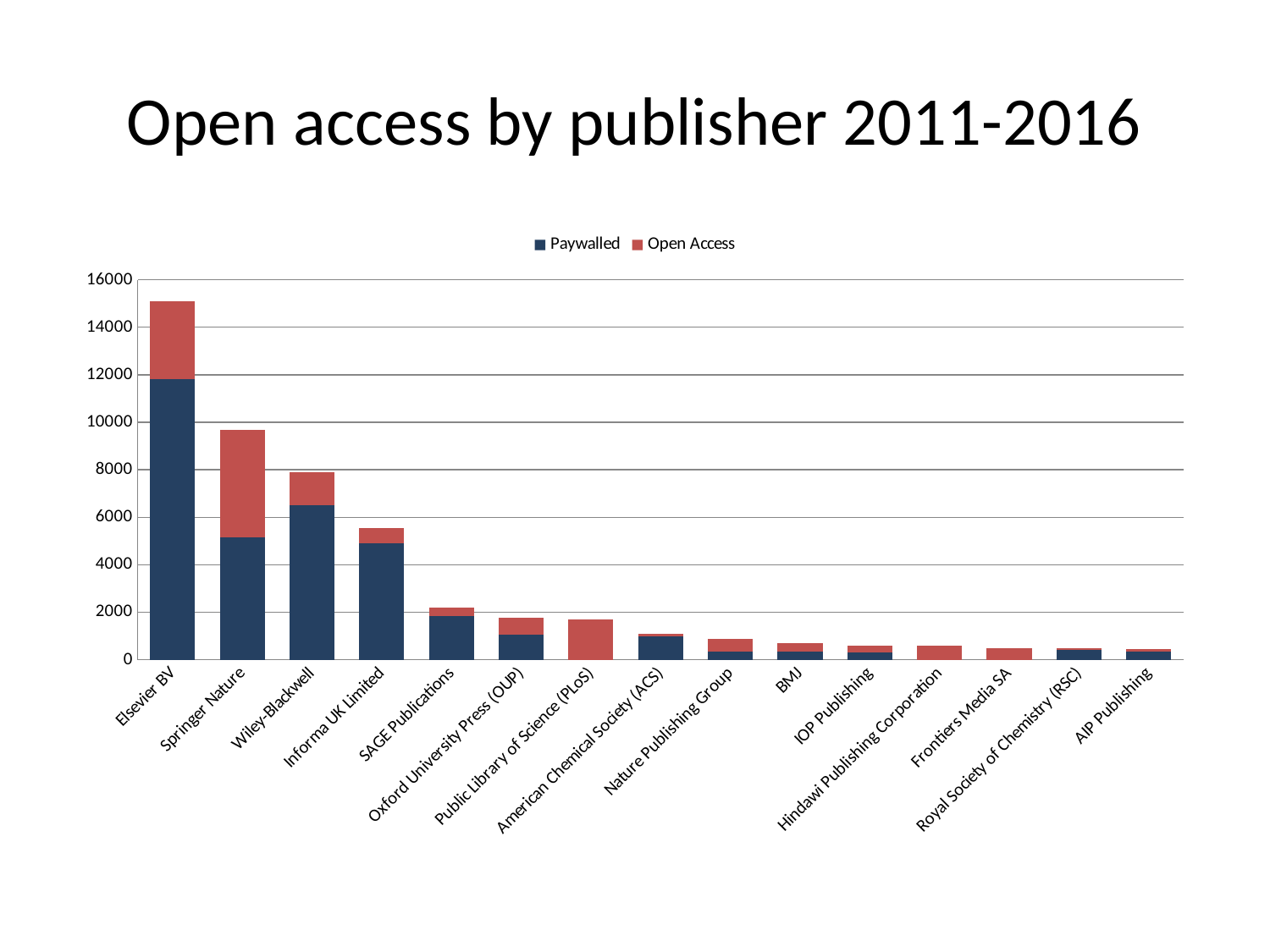
Is the total bar for Springer Nature greater or less than 10000? less What kind of chart is shown on the slide? stacked bar chart Is the Paywalled value for Wiley-Blackwell greater or less than 6000? greater Which publisher has the tallest total bar? Elsevier BV Which publisher has the largest Open Access segment? Springer Nature Is the total bar for Public Library of Science (PLoS) greater or less than 2000? less Which is larger, the Paywalled value for Wiley-Blackwell or the Paywalled value for Springer Nature? Wiley-Blackwell What is the title of the slide? Open access by publisher 2011-2016 Do the total bar heights generally rise or fall from left to right along the x axis? fall How many series does the legend list? 2 How many publishers are shown on the x axis? 15